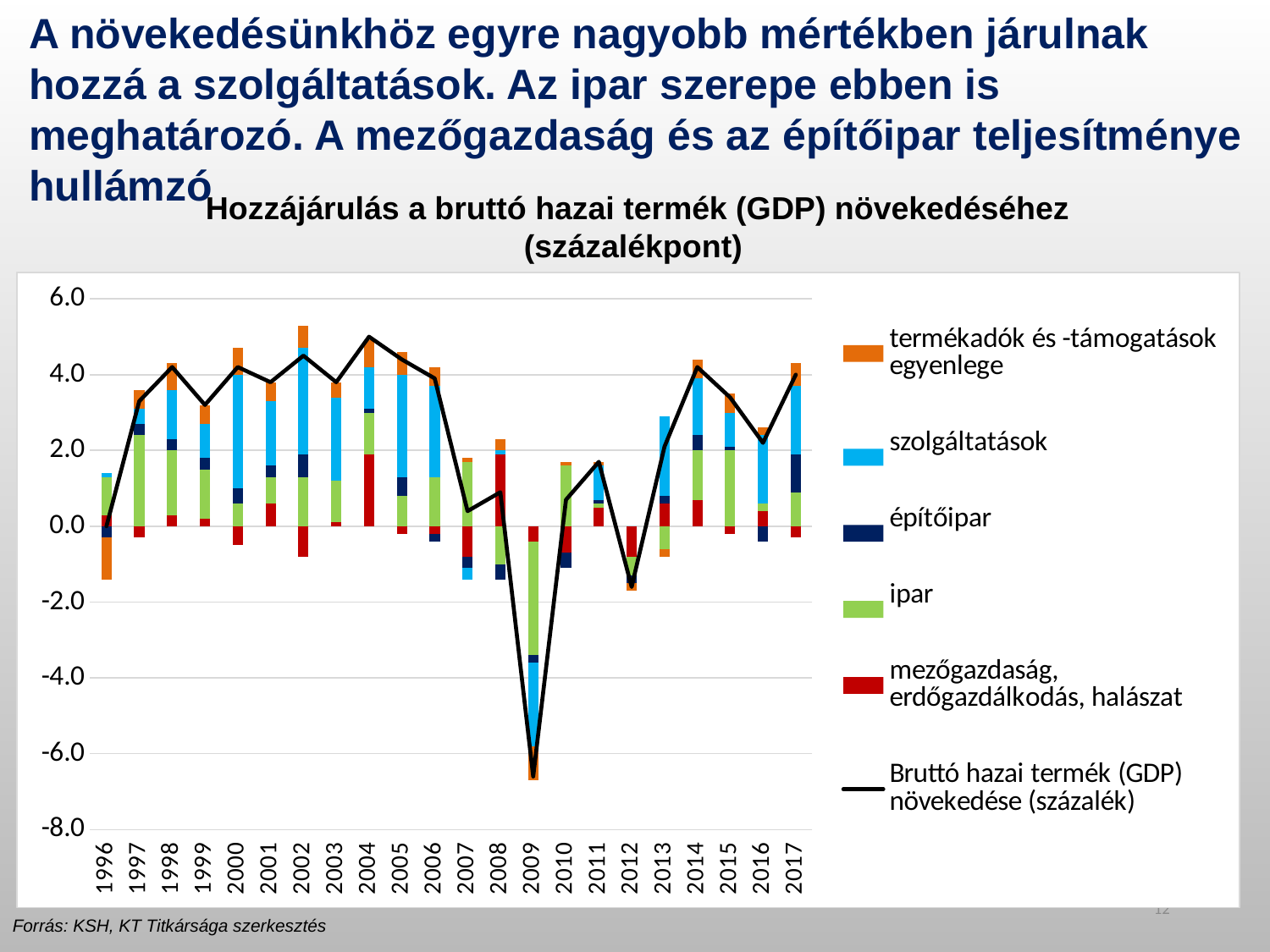
Is the GDP growth value for 2012 greater or less than 0.0? less How many years are shown on the x axis of the chart? 22 Is the GDP growth value for 2009 greater or less than -6.0? less In which year was GDP growth (the black line) lowest? 2009 What is the title of the chart? Hozzájárulás a bruttó hazai termék (GDP) növekedéséhez (százalékpont) Did GDP growth rise or fall from 2012 to 2014? rise How many series does the legend list? 6 Is the GDP growth value for 2004 greater or less than 4.0? greater Which year had higher GDP growth, 2014 or 2016? 2014 In which year was GDP growth (the black line) highest? 2004 Which legend entry is shown as a black line rather than a bar segment? Bruttó hazai termék (GDP) növekedése (százalék) What kind of chart is shown on the slide? Stacked bar chart with a line